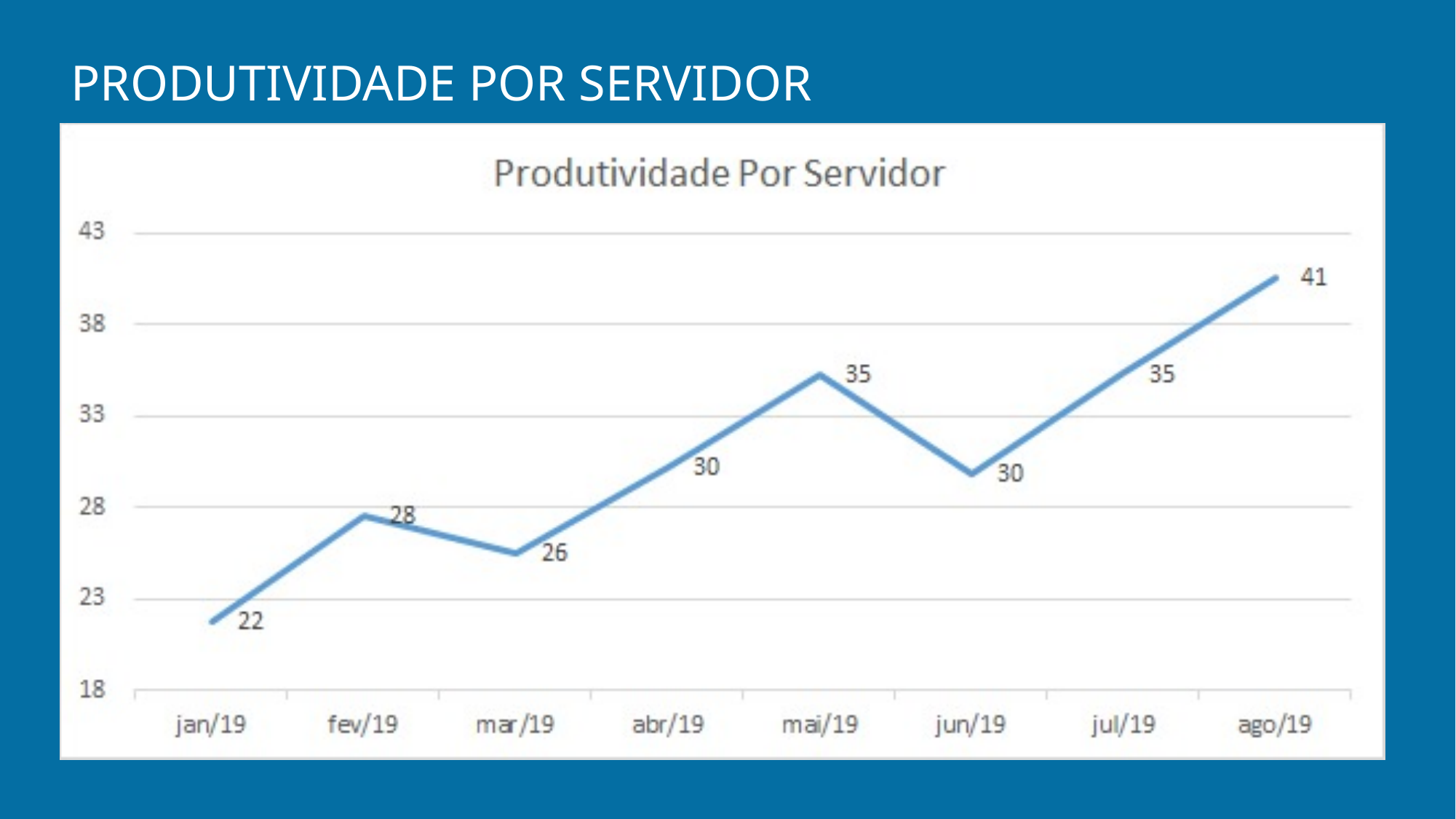
Which month has the lowest value? jan/19 What kind of chart is shown? line chart What is the difference between the values for mai/19 and jun/19? 5 Which month has the highest value? ago/19 What is the value for mai/19? 35 What is the value for ago/19? 41 What is the difference between the values for ago/19 and jan/19? 19 How many months are plotted on the chart? 8 Which is larger, the value for fev/19 or the value for mar/19? fev/19 What is the value for jan/19? 22 What is the title of the chart? Produtividade Por Servidor Is the value for jul/19 greater or less than 33? greater